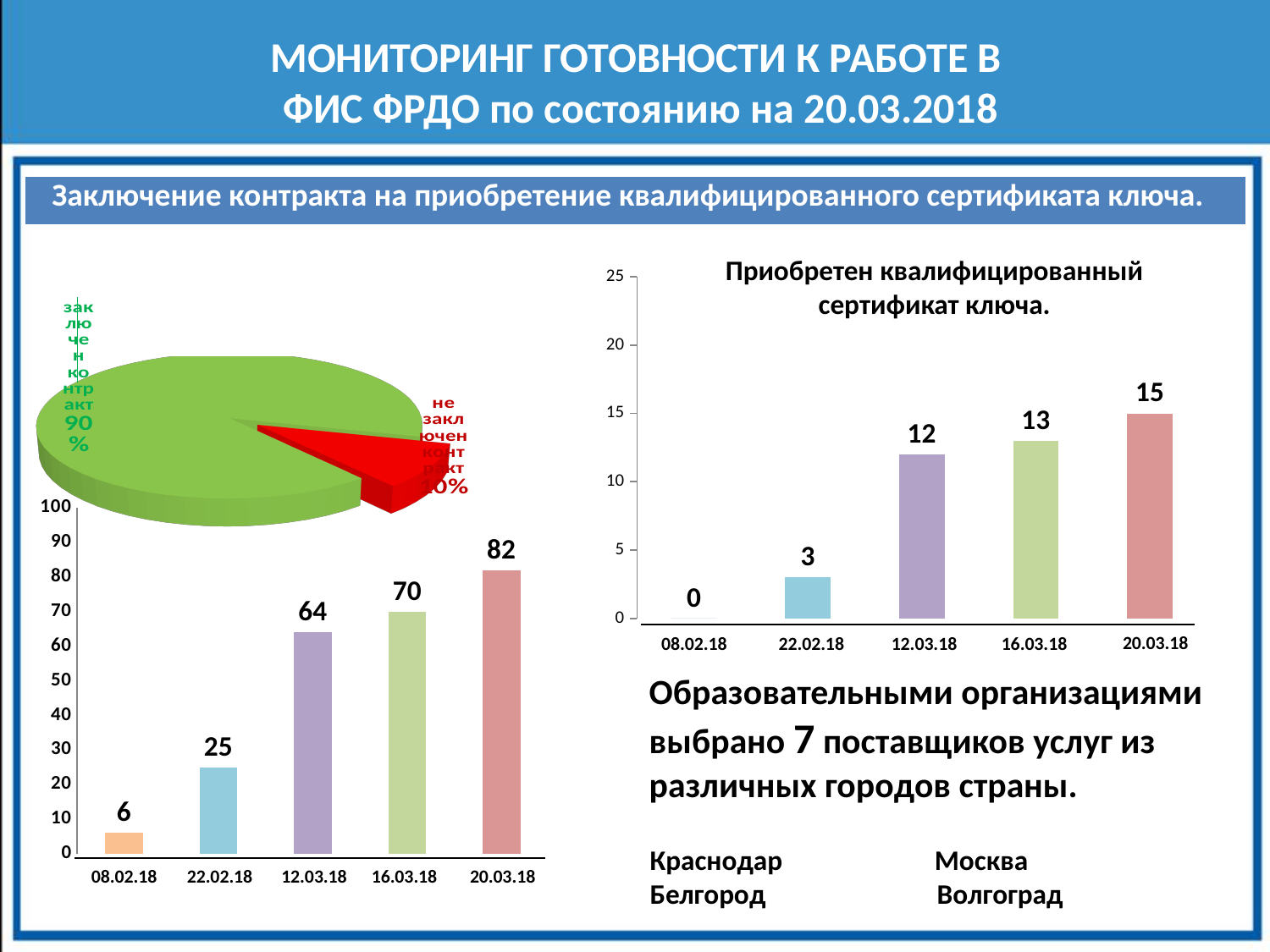
In the chart titled 'Приобретен квалифицированный сертификат ключа.', which is larger: the value for 16.03.18 or the value for 22.02.18? 16.03.18 In the chart titled 'Приобретен квалифицированный сертификат ключа.', what is the value for 12.03.18? 12 In the chart titled 'Приобретен квалифицированный сертификат ключа.', which date has the highest value? 20.03.18 In the bar chart at the bottom left of the slide, what is the value for 20.03.18? 82 In the chart titled 'Приобретен квалифицированный сертификат ключа.', what is the difference between the values for 20.03.18 and 22.02.18? 12 What kind of chart is shown at the top left of the slide? pie chart In the bar chart at the bottom left of the slide, do the values rise or fall from 08.02.18 to 20.03.18? rise In the bar chart at the bottom left of the slide, what is the value for 08.02.18? 6 In the bar chart at the bottom left of the slide, which date has the lowest value? 08.02.18 In the bar chart at the bottom left of the slide, what is the difference between the values for 20.03.18 and 16.03.18? 12 In the pie chart at the top left of the slide, what share is labelled 'заключен контракт'? 90% In the chart titled 'Приобретен квалифицированный сертификат ключа.', how many dates are shown on the x axis? 5